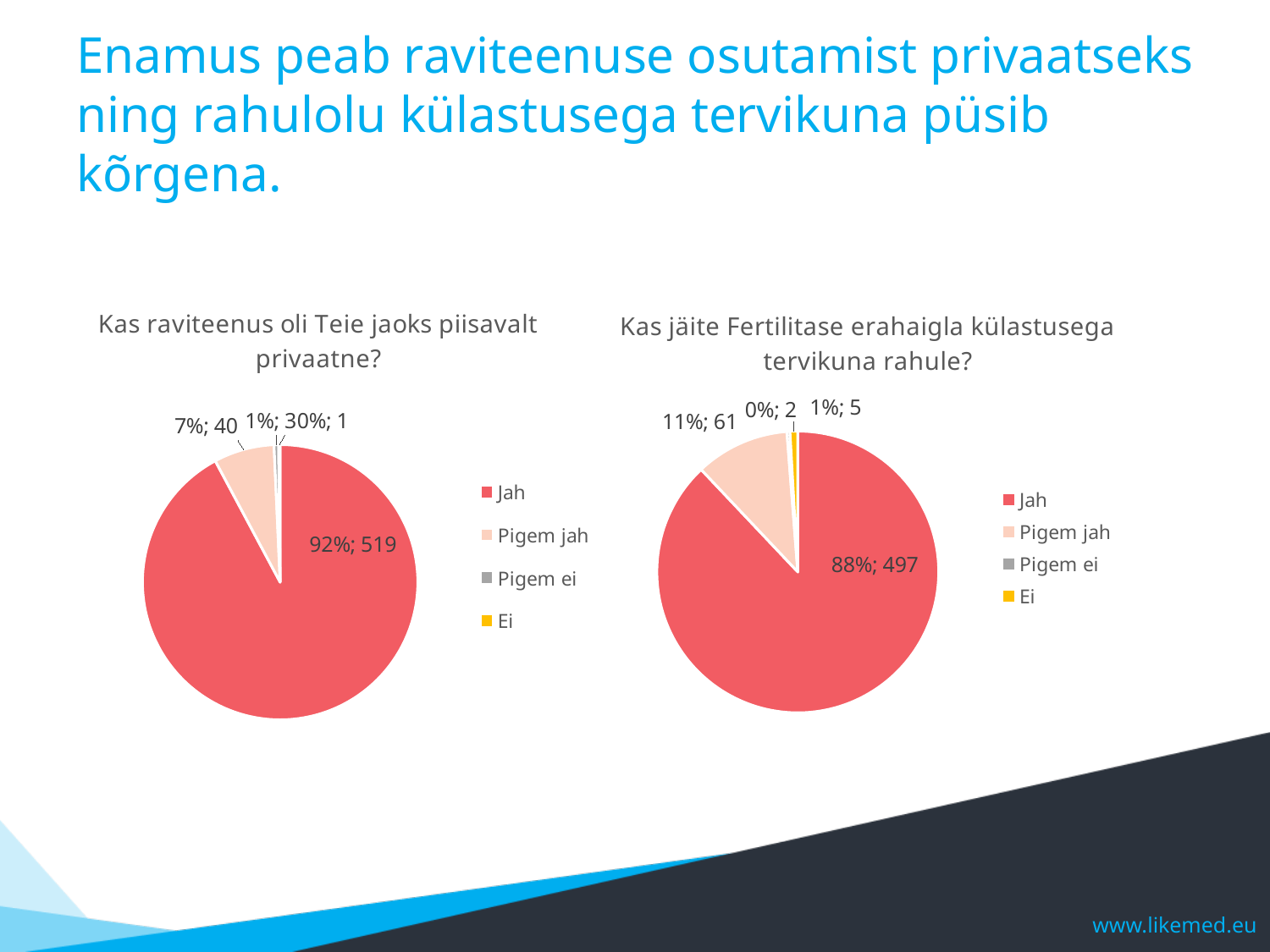
In the right pie chart (Kas jäite Fertilitase erahaigla külastusega tervikuna rahule?), how many respondents answered "Jah"? 497 How many categories does the legend of the right pie chart (Kas jäite Fertilitase erahaigla külastusega tervikuna rahule?) list? 4 In the right pie chart (Kas jäite Fertilitase erahaigla külastusega tervikuna rahule?), what is the difference between the number of "Jah" and "Pigem jah" responses? 436 In the right pie chart (Kas jäite Fertilitase erahaigla külastusega tervikuna rahule?), which category has the largest slice? Jah In the right pie chart (Kas jäite Fertilitase erahaigla külastusega tervikuna rahule?), how many respondents answered "Pigem jah"? 61 In the left pie chart (Kas raviteenus oli Teie jaoks piisavalt privaatne?), what share of the pie is "Jah"? 92% In the right pie chart (Kas jäite Fertilitase erahaigla külastusega tervikuna rahule?), what share of the pie is "Jah"? 88% In the left pie chart (Kas raviteenus oli Teie jaoks piisavalt privaatne?), which is larger, "Jah" or "Pigem jah"? Jah In the right pie chart (Kas jäite Fertilitase erahaigla külastusega tervikuna rahule?), how many respondents answered "Ei"? 5 In the left pie chart (Kas raviteenus oli Teie jaoks piisavalt privaatne?), how many respondents answered "Jah"? 519 In the left pie chart (Kas raviteenus oli Teie jaoks piisavalt privaatne?), how many respondents answered "Pigem jah"? 40 What type of chart is used on the left (Kas raviteenus oli Teie jaoks piisavalt privaatne?)? Pie chart